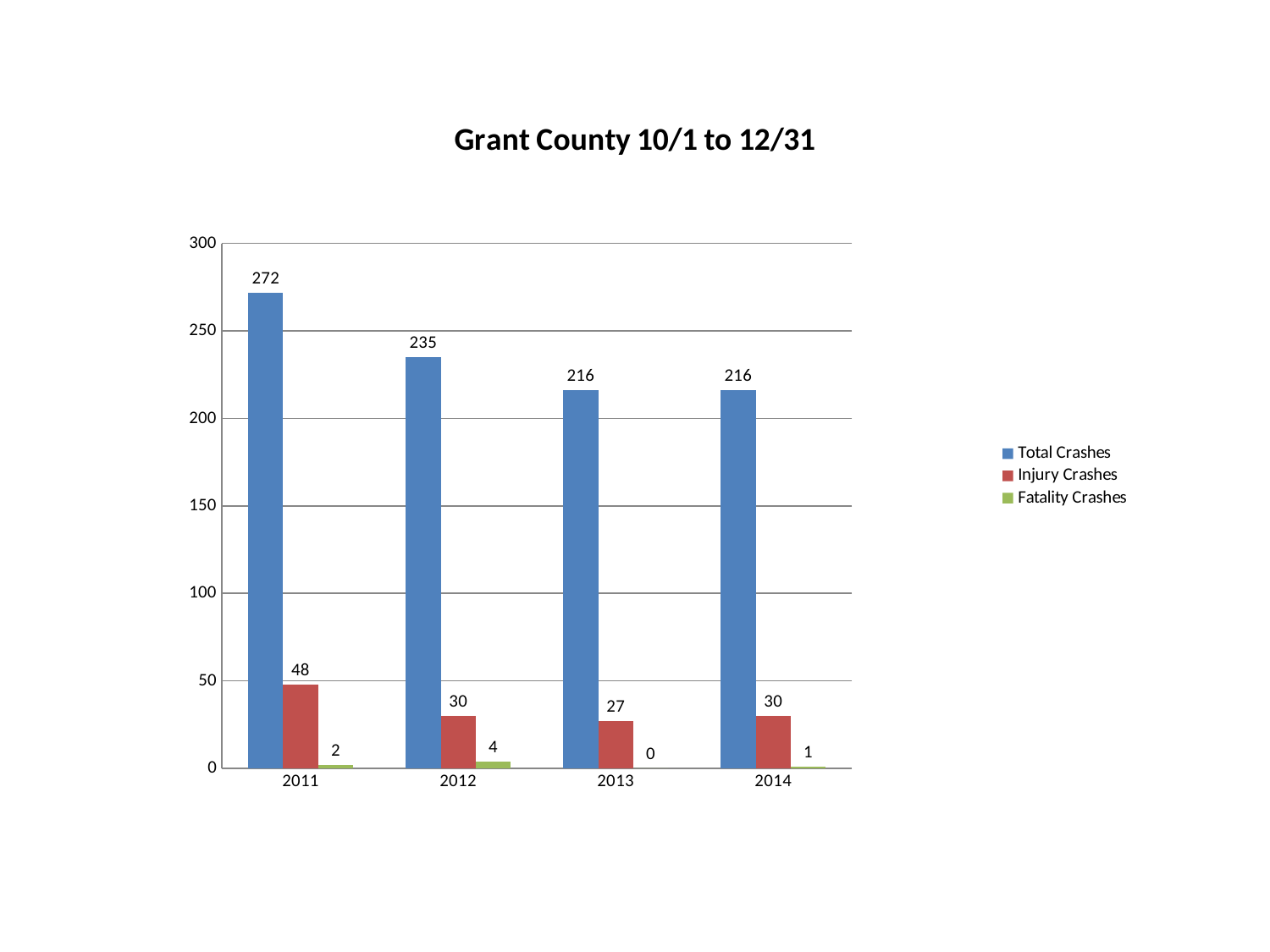
What is the value of Injury Crashes for 2013? 27 Is the value of Total Crashes for 2013 greater or less than 250? less What is the value of Total Crashes for 2011? 272 What is the title of the chart? Grant County 10/1 to 12/31 How many series does the legend list? 3 Which is larger, Injury Crashes in 2011 or Injury Crashes in 2014? Injury Crashes in 2011 What is the value of Fatality Crashes for 2012? 4 Which year has the lowest number of Fatality Crashes? 2013 What kind of chart is shown on the slide? bar chart Which year has the highest number of Total Crashes? 2011 How many years are shown on the x axis? 4 What is the difference in Total Crashes between 2011 and 2012? 37